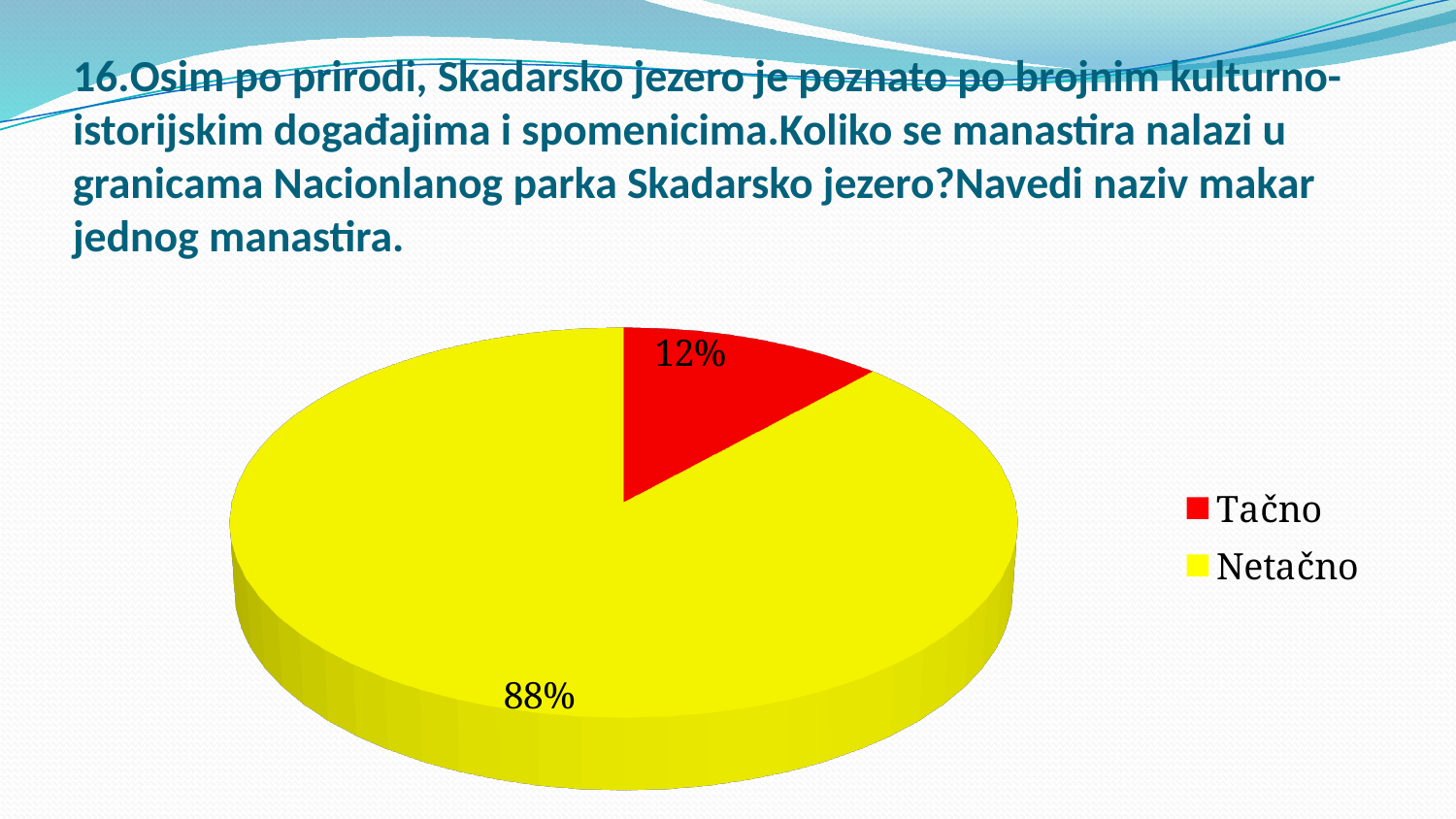
What is the difference in percentage points between the Netačno and Tačno slices? 76 What colour is the Netačno slice? yellow Which slice of the pie is the smallest? Tačno What share of the pie does the Netačno slice take? 88% Which is larger, the Tačno slice or the Netačno slice? Netačno What kind of chart is shown on the slide? pie chart What percentage of the pie is labelled Tačno? 12% How many slices does the pie chart have? 2 What percentage of the pie is labelled Netačno? 88% What colour is the Tačno slice? red Which slice of the pie is the largest? Netačno How many entries does the legend list? 2